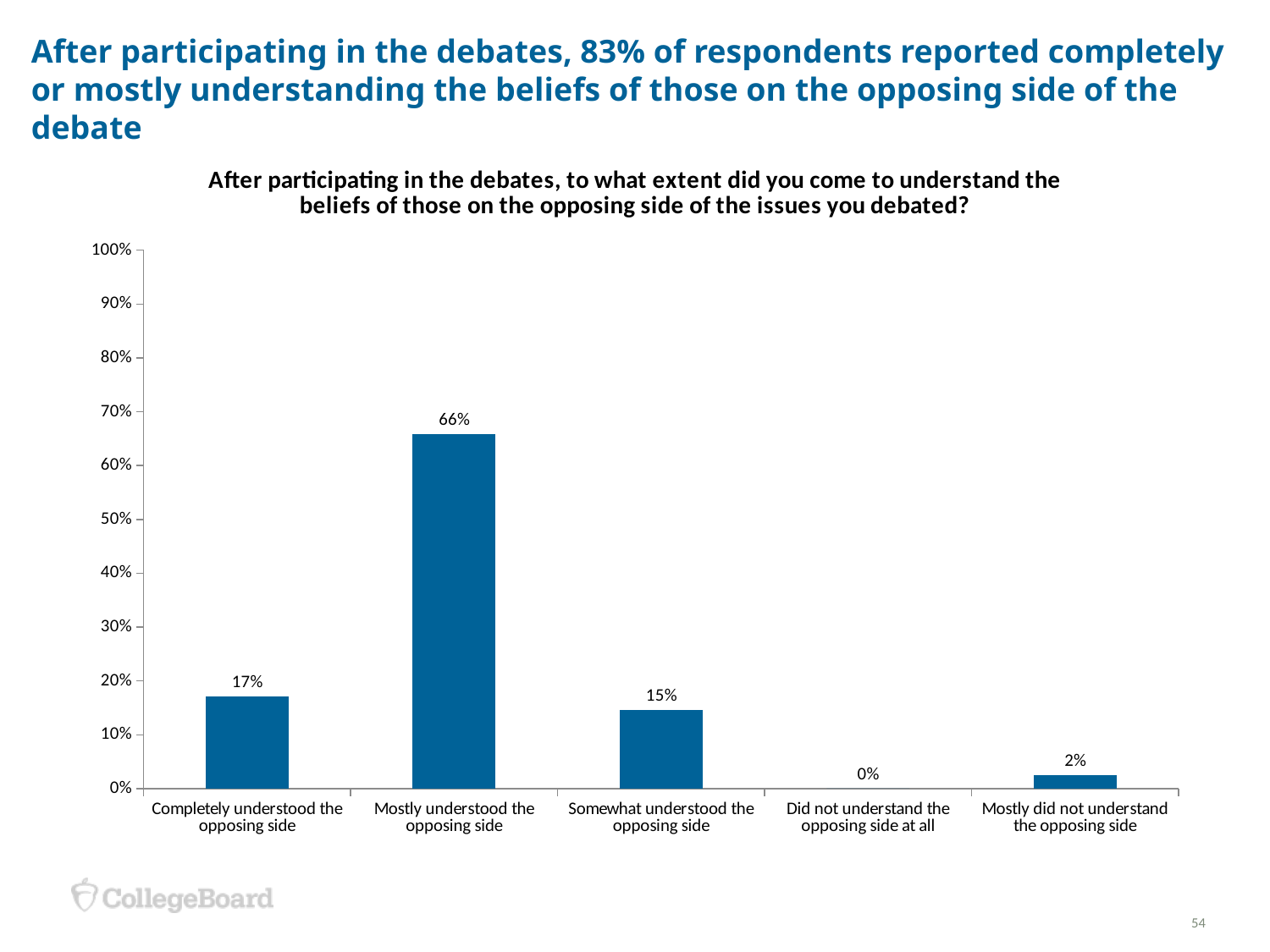
What type of chart is shown on the slide? Bar chart What percentage of respondents reported that they mostly did not understand the opposing side? 2% What percentage of respondents reported that they completely understood the opposing side? 17% Which response category has the lowest percentage? Did not understand the opposing side at all Which is larger: the percentage for 'Completely understood the opposing side' or for 'Somewhat understood the opposing side'? Completely understood the opposing side What is the combined percentage of respondents who completely or mostly understood the opposing side? 83% What percentage of respondents reported that they somewhat understood the opposing side? 15% Which response category has the highest percentage? Mostly understood the opposing side How many response categories are shown on the x axis? 5 Is the value for 'Mostly understood the opposing side' greater or less than 60%? greater What percentage of respondents reported that they mostly understood the opposing side? 66% What is the difference in percentage points between 'Mostly understood the opposing side' and 'Completely understood the opposing side'? 49